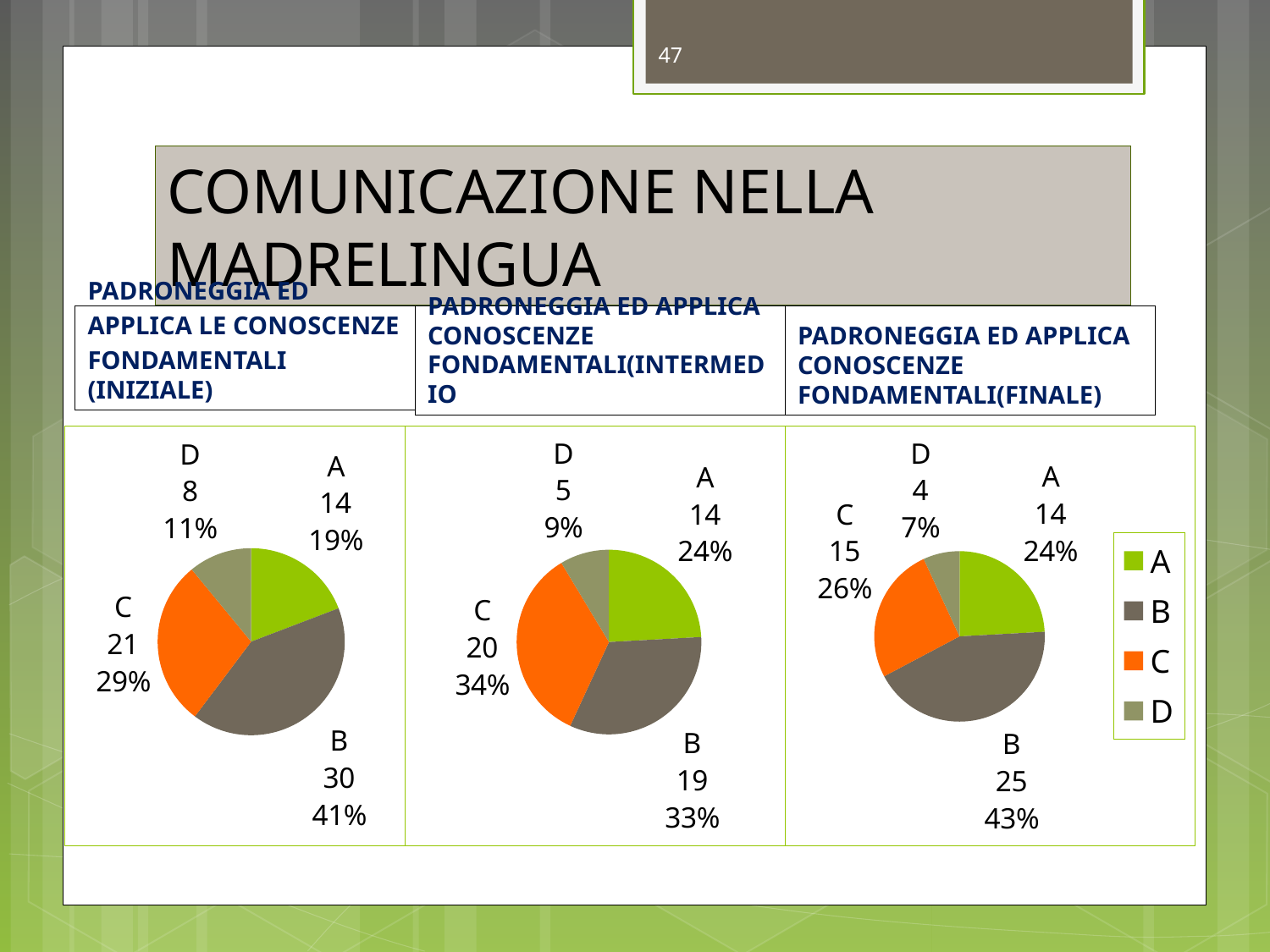
How many categories does each pie chart on the slide show? 4 In the right pie chart (FINALE), what is the value for category D? 4 In the right pie chart (FINALE), which is larger, the value for C or the value for A? C In the middle pie chart (INTERMEDIO), what is the value for category C? 20 In the right pie chart (FINALE), what percentage share does category B have? 43% In the left pie chart (INIZIALE), what percentage share does category C have? 29% In the left pie chart (INIZIALE), what is the value for category B? 30 In the middle pie chart (INTERMEDIO), what is the difference between the values for C and A? 6 In the left pie chart (INIZIALE), which category has the smallest value? D What type of charts are shown on the slide? Pie charts In the right pie chart (FINALE), which category has the largest value? B In the middle pie chart (INTERMEDIO), what percentage share does category D have? 9%